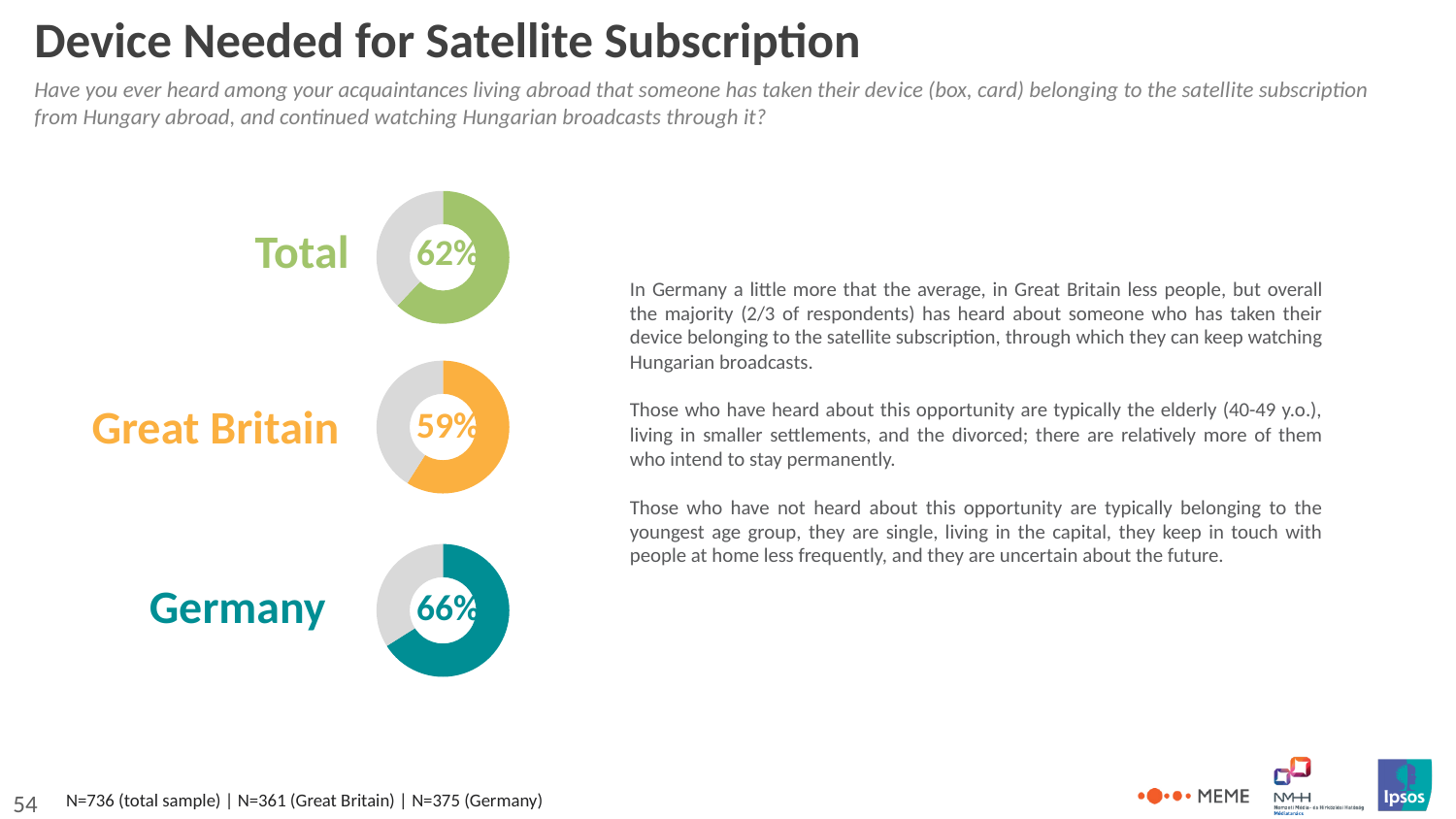
Which is larger, the percentage in the Great Britain donut chart or the percentage in the Total donut chart? Total How many donut charts are shown on the slide? 3 What colour is the filled portion of the Germany donut chart? Teal What is the difference in percentage points between the Germany donut chart and the Total donut chart? 4 Which of the three donut charts (Total, Great Britain, Germany) shows the lowest percentage? Great Britain What percentage is shown in the Germany donut chart? 66% What percentage is shown in the Total donut chart? 62% What colour is the filled portion of the Great Britain donut chart? Orange What kind of chart is used to show the Germany value? Donut (pie) chart What percentage is shown in the Great Britain donut chart? 59% Which of the three donut charts (Total, Great Britain, Germany) shows the highest percentage? Germany What is the difference in percentage points between the Germany donut chart and the Great Britain donut chart? 7